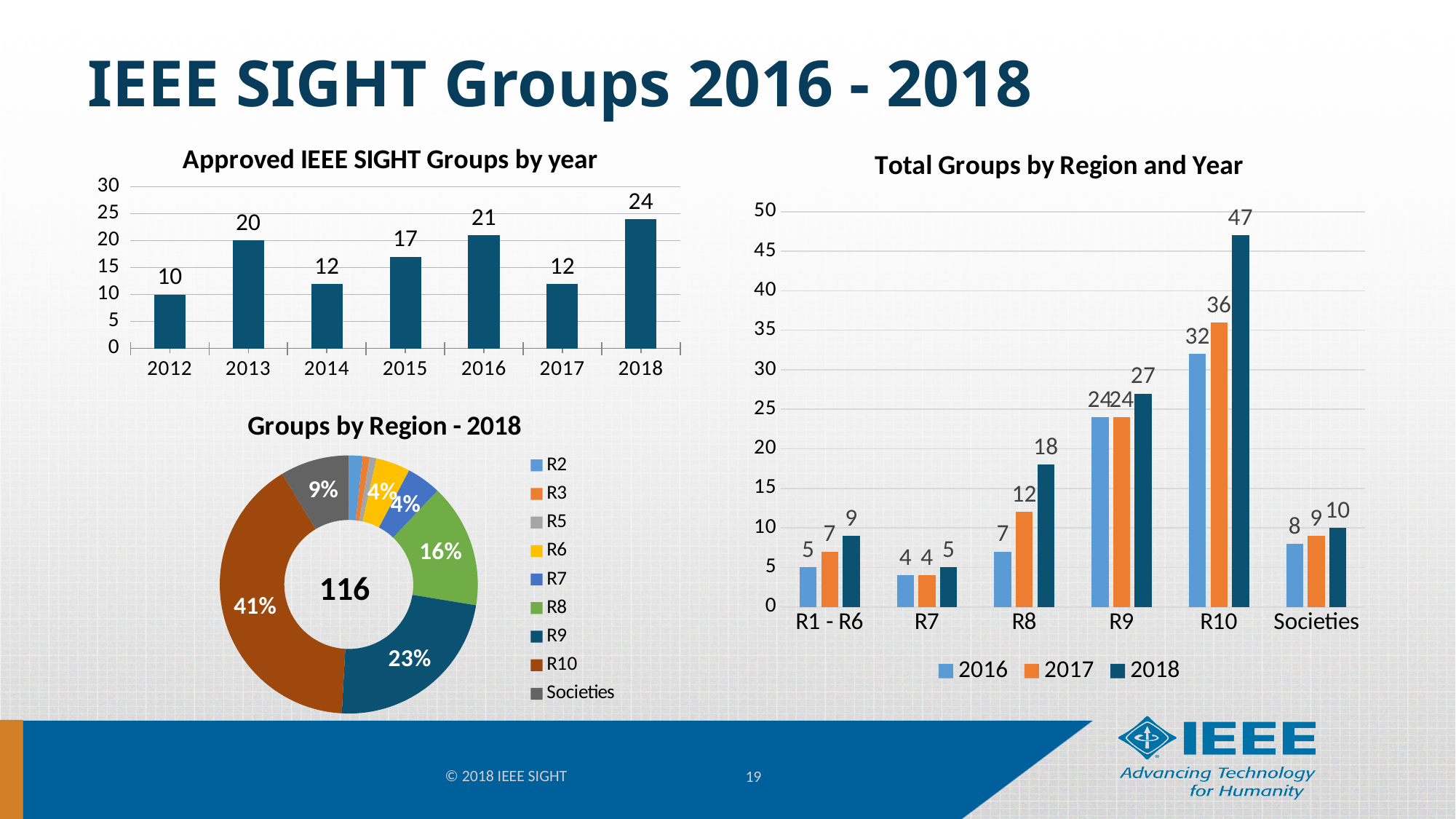
In the 'Approved IEEE SIGHT Groups by year' chart, how many groups were approved in 2018? 24 In the 'Total Groups by Region and Year' chart, what is the value for R8 in 2017? 12 In the 'Approved IEEE SIGHT Groups by year' chart, what is the difference between the 2013 and 2014 values? 8 In the 'Total Groups by Region and Year' chart, which region has the highest value in 2016? R10 In the 'Total Groups by Region and Year' chart, how many series does the legend list? 3 In the 'Total Groups by Region and Year' chart, what is the value for R10 in 2018? 47 In the 'Approved IEEE SIGHT Groups by year' chart, how many years are shown on the x axis? 7 In the 'Total Groups by Region and Year' chart, is the 2018 value for R9 larger than the 2018 value for R8? Yes In the 'Approved IEEE SIGHT Groups by year' chart, which year has the lowest value? 2012 What kind of chart is 'Groups by Region - 2018'? Doughnut (pie) chart In the 'Groups by Region - 2018' chart, what share of the groups is R10? 41% In the 'Total Groups by Region and Year' chart, what is the difference between the 2018 and 2016 values for R10? 15